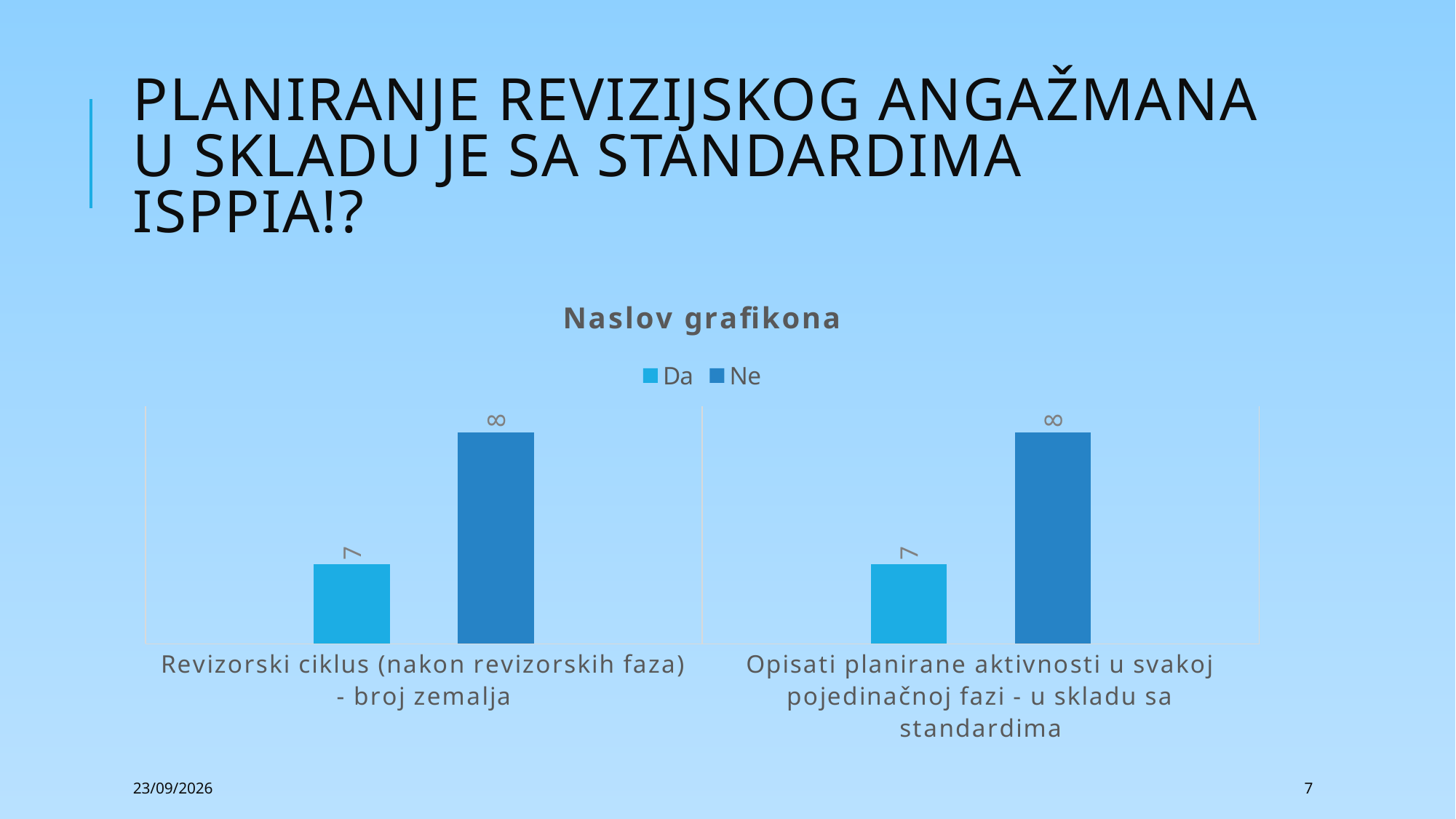
What is the value of "Da" for "Revizorski ciklus (nakon revizorskih faza) - broj zemalja"? 7 How many series does the chart legend list? 2 Which series has the larger value for "Revizorski ciklus (nakon revizorskih faza) - broj zemalja", Da or Ne? Ne What is the total of the "Da" and "Ne" values for "Revizorski ciklus (nakon revizorskih faza) - broj zemalja"? 15 What is the value of "Ne" for "Revizorski ciklus (nakon revizorskih faza) - broj zemalja"? 8 What is the title of the chart? Naslov grafikona What kind of chart is shown on the slide? bar chart How many categories are shown on the x axis of the chart? 2 What is the difference between the "Ne" and "Da" values for "Opisati planirane aktivnosti u svakoj pojedinačnoj fazi - u skladu sa standardima"? 1 Which series are listed in the chart legend? Da, Ne What is the value of "Ne" for "Opisati planirane aktivnosti u svakoj pojedinačnoj fazi - u skladu sa standardima"? 8 What is the value of "Da" for "Opisati planirane aktivnosti u svakoj pojedinačnoj fazi - u skladu sa standardima"? 7